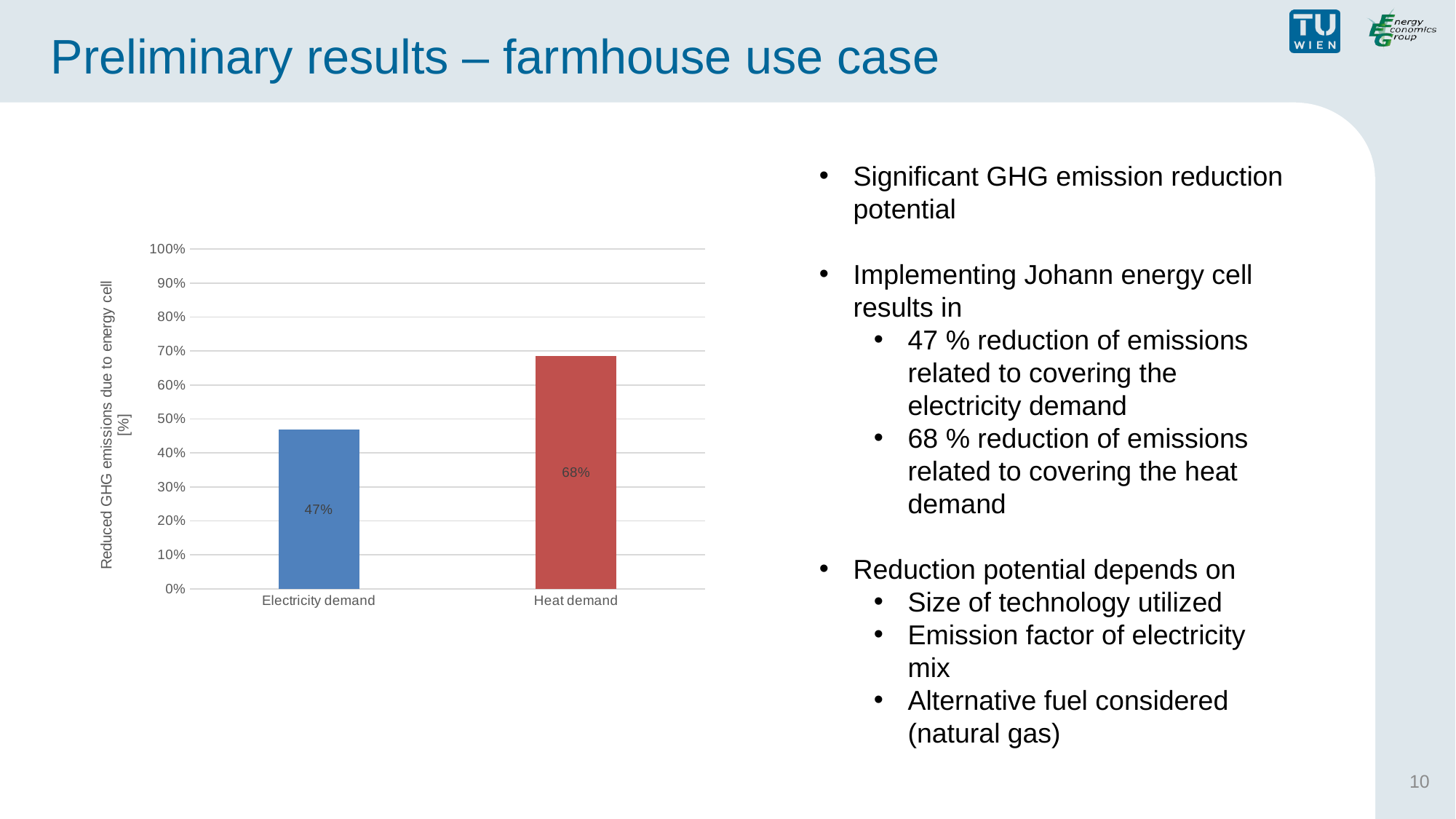
What is the value for Heat demand? 68% What is the difference between the values for Heat demand and Electricity demand? 21% What is the value for Electricity demand? 47% What is the label of the vertical axis? Reduced GHG emissions due to energy cell [%] Which category has the lowest value? Electricity demand Which is larger, the value for Electricity demand or the value for Heat demand? Heat demand Is the value for Electricity demand greater or less than 50%? less Is the value for Heat demand greater or less than 60%? greater How many categories are shown on the x axis? 2 What colour is the bar for Heat demand? red Which category has the highest value? Heat demand What kind of chart is shown on the slide? bar chart